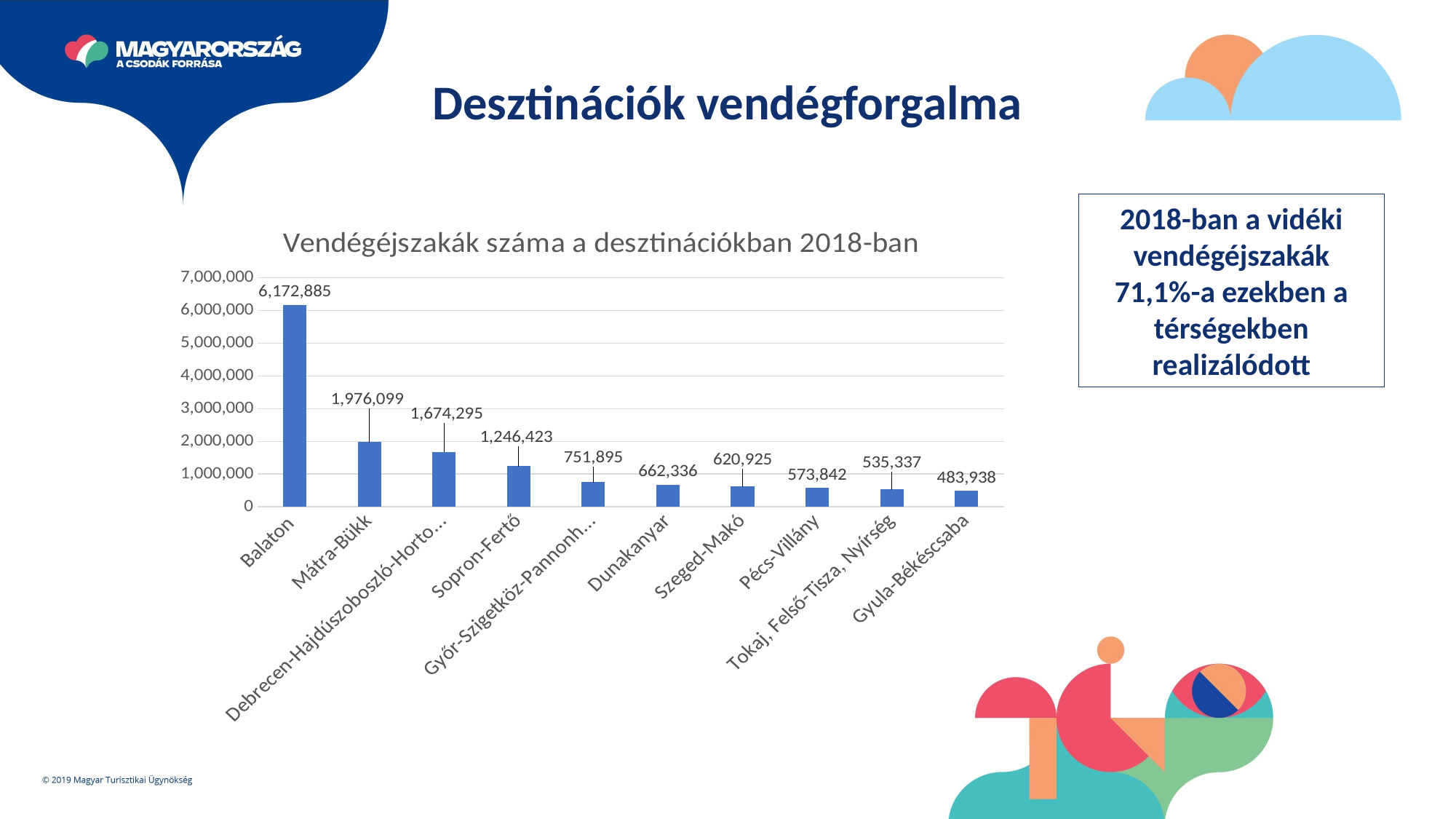
Which is larger, the value for Pécs-Villány or the value for Gyula-Békéscsaba? Pécs-Villány What is the value for Balaton? 6,172,885 What is the difference between the values for Dunakanyar and Szeged-Makó? 41,411 What is the value for Dunakanyar? 662,336 Which destination has the highest number of guest nights? Balaton What is the difference between the values for Balaton and Mátra-Bükk? 4,196,786 What is the value for Sopron-Fertő? 1,246,423 What is the value for Tokaj, Felső-Tisza, Nyírség? 535,337 What is the title of the chart? Vendégéjszakák száma a desztinációkban 2018-ban How many destinations are shown on the chart? 10 Which destination has the lowest number of guest nights? Gyula-Békéscsaba What kind of chart is shown on the slide? Bar chart